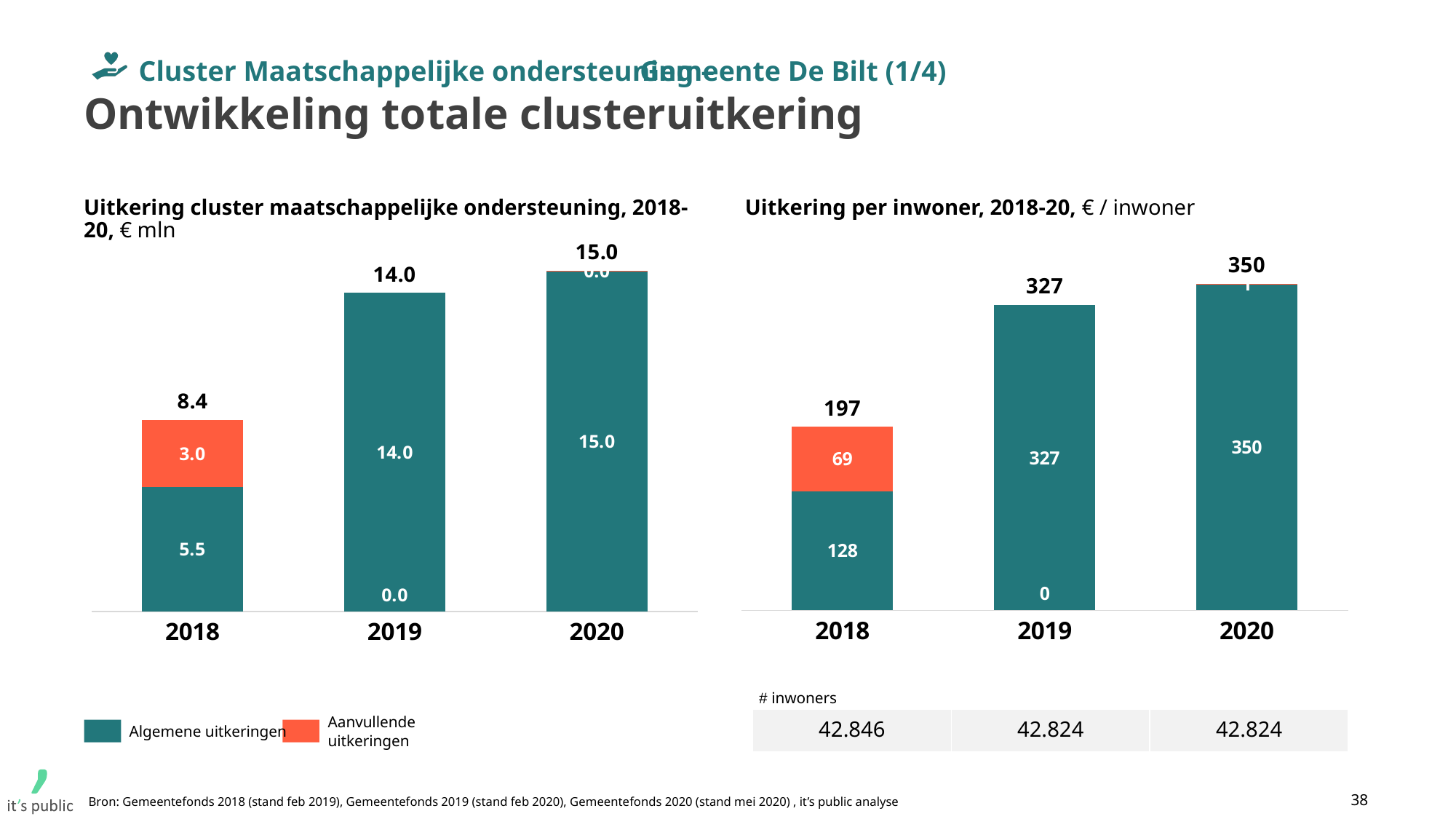
In the left chart (Uitkering cluster maatschappelijke ondersteuning), do the total values rise or fall from 2018 to 2020? rise In the left chart (Uitkering cluster maatschappelijke ondersteuning), what is the value of Aanvullende uitkeringen in 2018? 3.0 In the right chart (Uitkering per inwoner), what is the value of Algemene uitkeringen per inwoner in 2018? 128 In the right chart (Uitkering per inwoner), what is the difference between the total for 2020 and the total for 2019? 23 In the left chart (Uitkering cluster maatschappelijke ondersteuning), what is the total uitkering for 2018? 8.4 In the right chart (Uitkering per inwoner), what is the total uitkering per inwoner in 2018? 197 What kind of chart is the right chart (Uitkering per inwoner)? stacked bar chart In the right chart (Uitkering per inwoner), which year has the lowest total uitkering per inwoner? 2018 In the left chart (Uitkering cluster maatschappelijke ondersteuning), what is the value of Algemene uitkeringen in 2019? 14.0 How many series does the legend of the left chart list? 2 In the left chart (Uitkering cluster maatschappelijke ondersteuning), how much higher is the total for 2020 than for 2019? 1.0 In the left chart (Uitkering cluster maatschappelijke ondersteuning), which year has the highest total uitkering? 2020